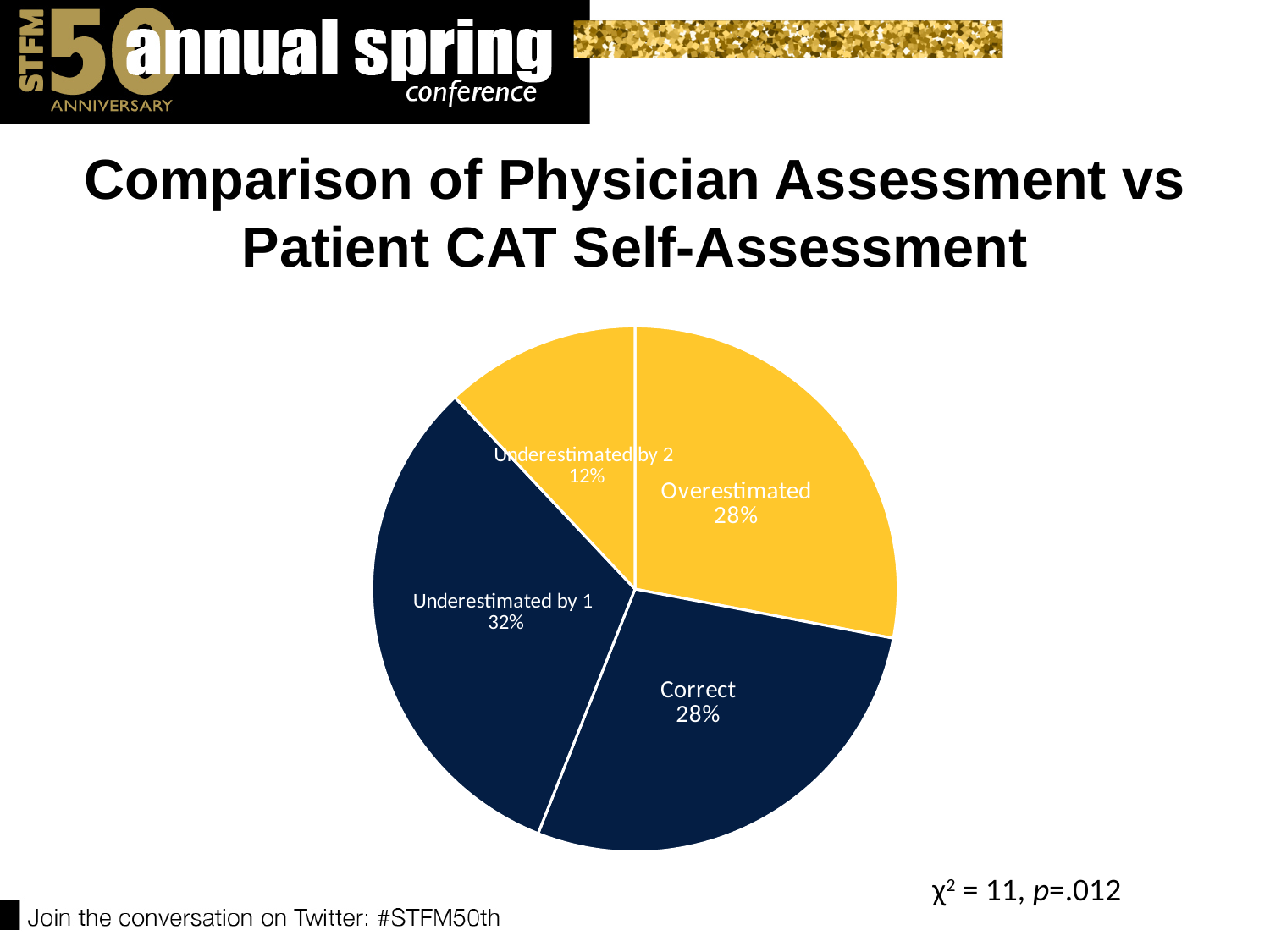
What percentage of the pie is labelled Correct? 28% What colour is the Overestimated slice? Yellow What kind of chart is shown on the slide? Pie chart What percentage of the pie is labelled Underestimated by 1? 32% Which is larger, the Underestimated by 1 slice or the Correct slice? Underestimated by 1 What is the difference in percentage points between Underestimated by 1 and Underestimated by 2? 20 How many slices does the pie chart have? 4 What percentage of the pie is labelled Underestimated by 2? 12% Which slice of the pie is the smallest? Underestimated by 2 What percentage of the pie is labelled Overestimated? 28% Which slice of the pie is the largest? Underestimated by 1 What is the title of the chart on the slide? Comparison of Physician Assessment vs Patient CAT Self-Assessment